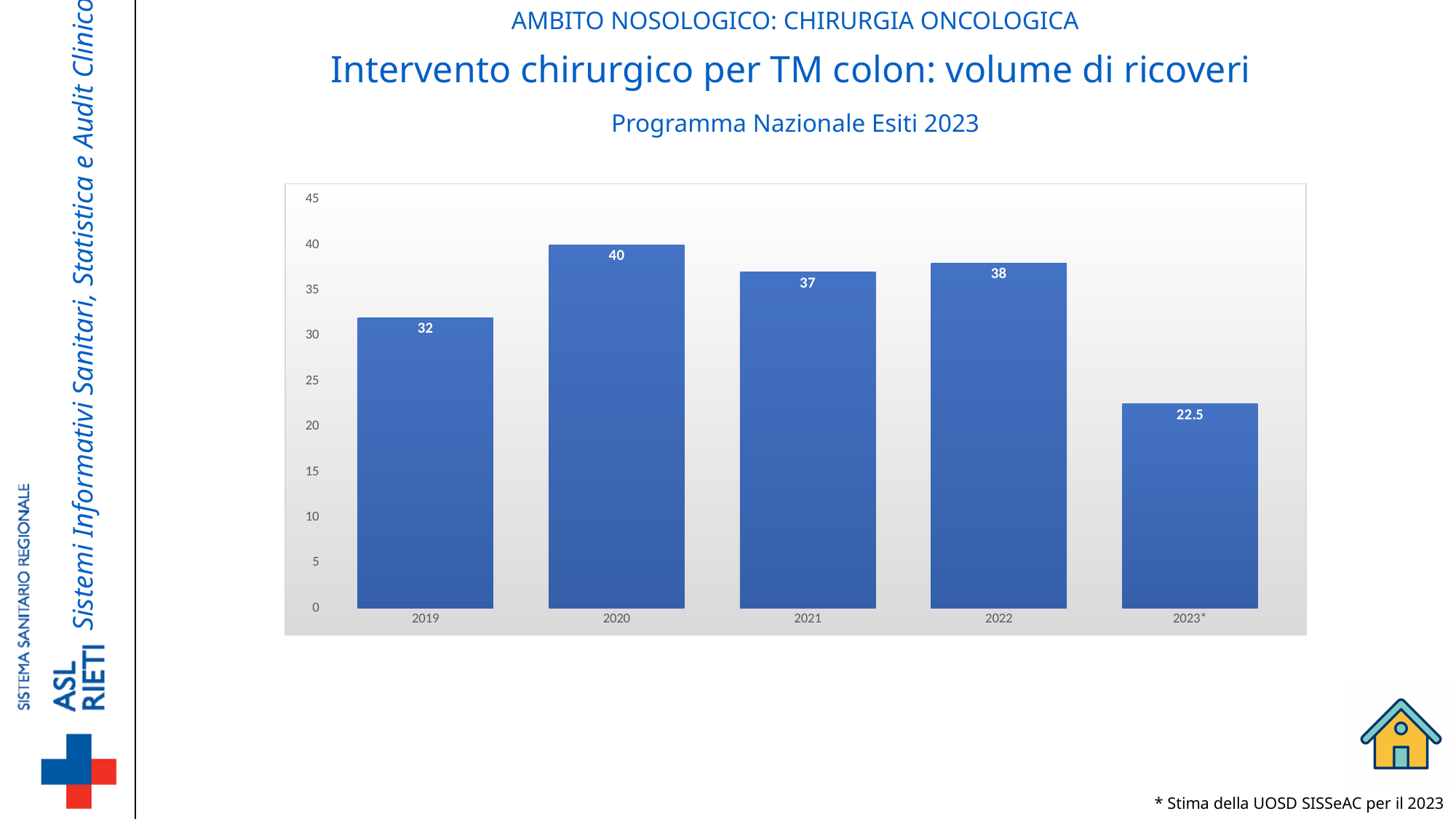
What is the value for 2020? 40 Is the value for 2021 greater or less than 35? greater Do the values rise or fall from 2022 to 2023*? fall What kind of chart is shown on the slide? bar chart What is the difference between the values for 2020 and 2019? 8 Which year has the highest value? 2020 How many years are shown on the x axis? 5 What is the value for 2019? 32 Which year has the lowest value? 2023* Which is larger, the value for 2021 or the value for 2022? 2022 What is the difference between the values for 2022 and 2023*? 15.5 What is the value for 2023*? 22.5